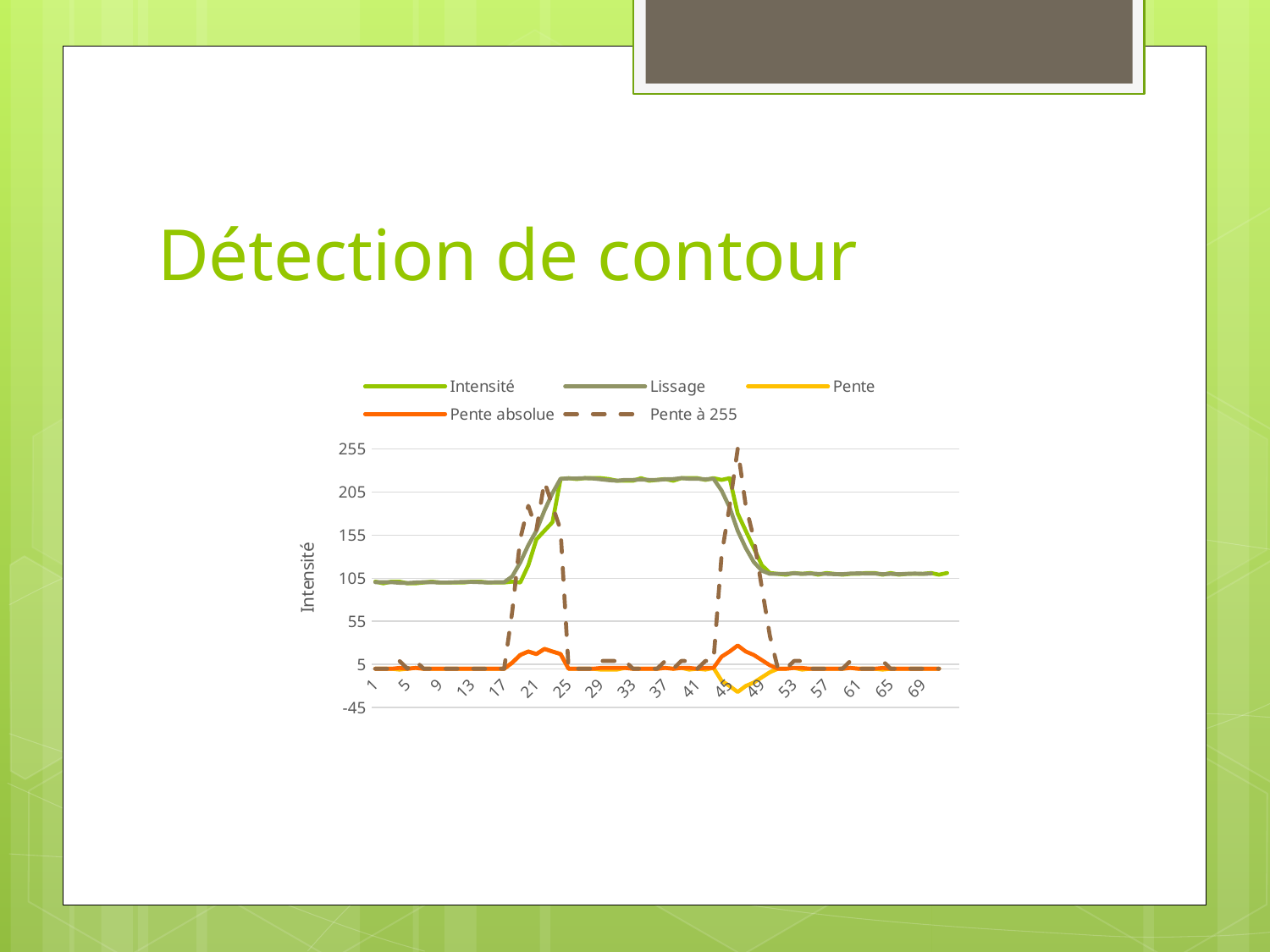
Is the value of the Pente absolue series at x = 33 greater or less than 55? less What is the label of the vertical axis of the chart? Intensité Does the Intensité series rise or fall between x = 17 and x = 25? rise Which series in the legend is drawn with a dashed line? Pente à 255 How many series does the chart legend list? 5 Is the value of the Lissage series at x = 61 greater or less than 155? less What kind of chart is shown on the slide? line chart Is the value of the Intensité series at x = 5 greater or less than 155? less Which is larger for the Intensité series: the value at x = 33 or the value at x = 5? x = 33 Does the Intensité series rise or fall between x = 41 and x = 49? fall